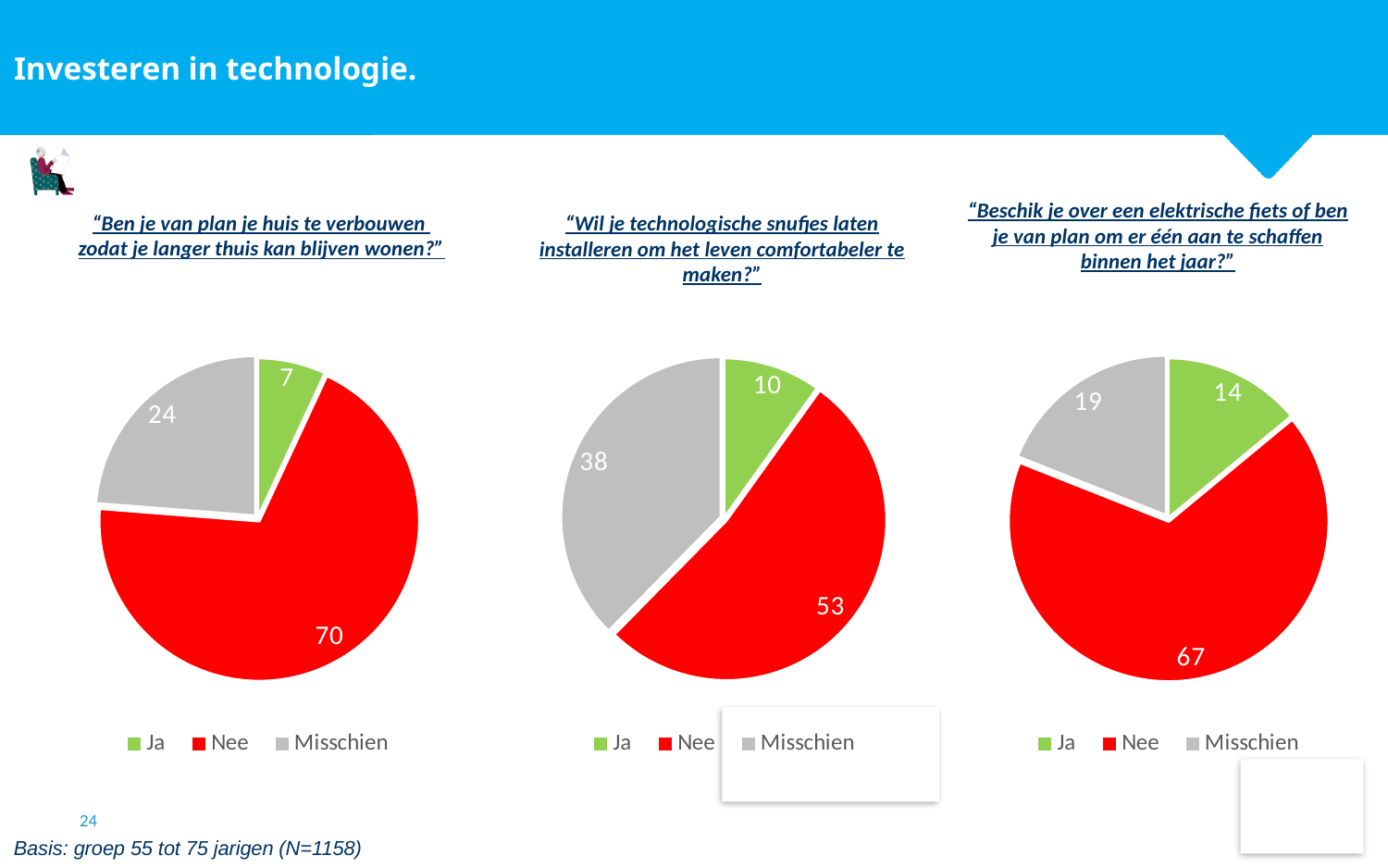
How many slices does the left pie chart have? 3 In the right pie chart ("Beschik je over een elektrische fiets..."), what is the value for Ja? 14 What colour represents Nee in the pie charts? Red In the middle pie chart, which is larger, the value for Ja or the value for Misschien? Misschien In the left pie chart ("Ben je van plan je huis te verbouwen..."), what is the value for Nee? 70 In the right pie chart, what is the difference between the values for Nee and Misschien? 48 In the middle pie chart, which category has the largest slice? Nee What type of chart is used for the middle chart on the slide? Pie chart In the left pie chart, which category has the smallest slice? Ja In the left pie chart, what is the difference between the values for Misschien and Ja? 17 In the middle pie chart ("Wil je technologische snufjes laten installeren..."), what is the value for Misschien? 38 How many entries does the legend of the right chart list? 3